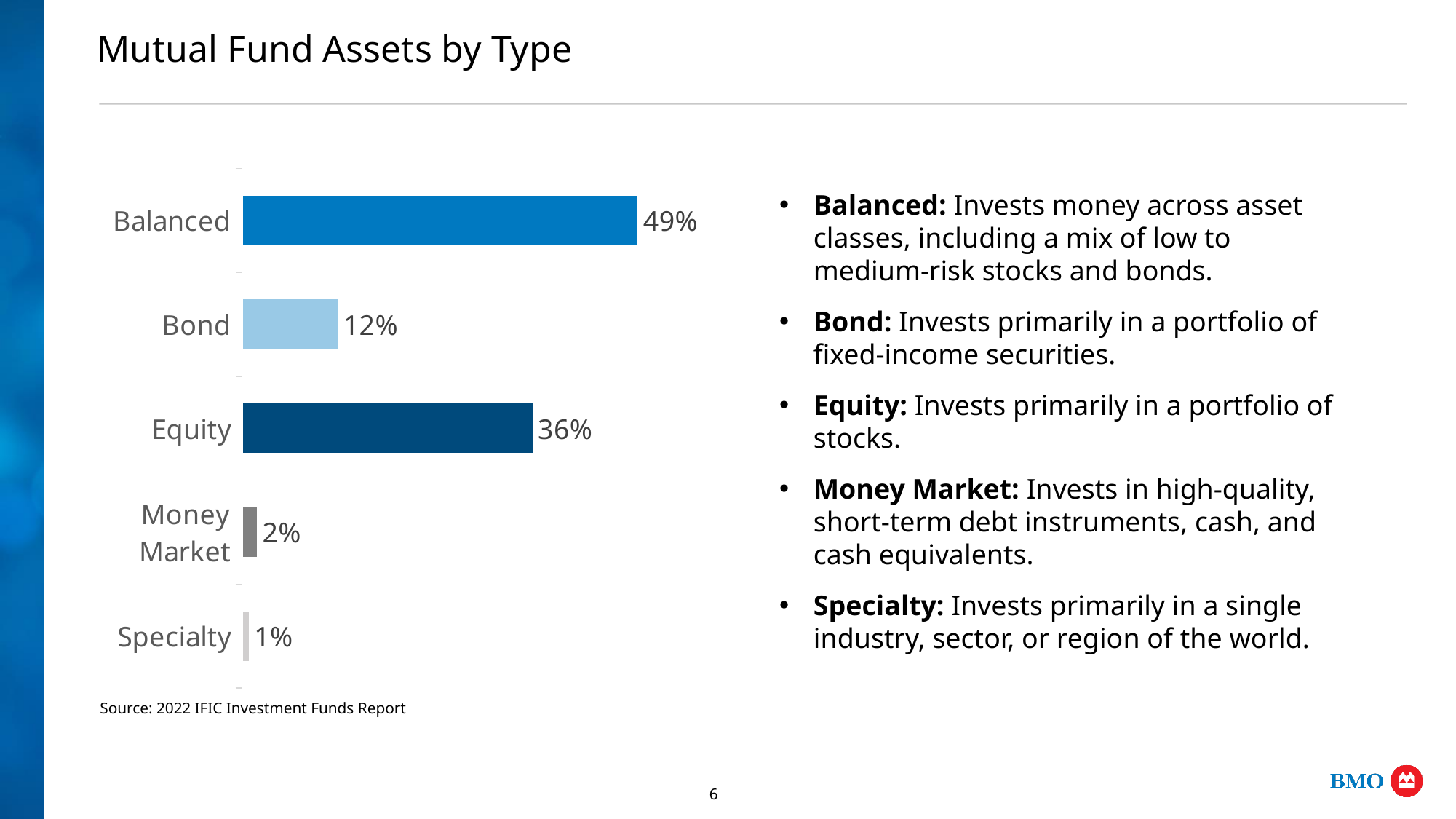
What is the value shown for Bond funds? 12% How many fund types are shown in the chart? 5 What kind of chart is used to show mutual fund assets by type? Bar chart What is the difference between the Balanced and Equity shares? 13% Which fund type has the largest share of mutual fund assets? Balanced What share of mutual fund assets is in Equity funds? 36% What is the value shown for Specialty funds? 1% Which fund type has the smallest share of mutual fund assets? Specialty What is the difference between the Bond and Money Market shares? 10% Which is larger, the share for Bond or the share for Equity? Equity What is the value shown for Money Market funds? 2% What percentage of mutual fund assets is in Balanced funds? 49%